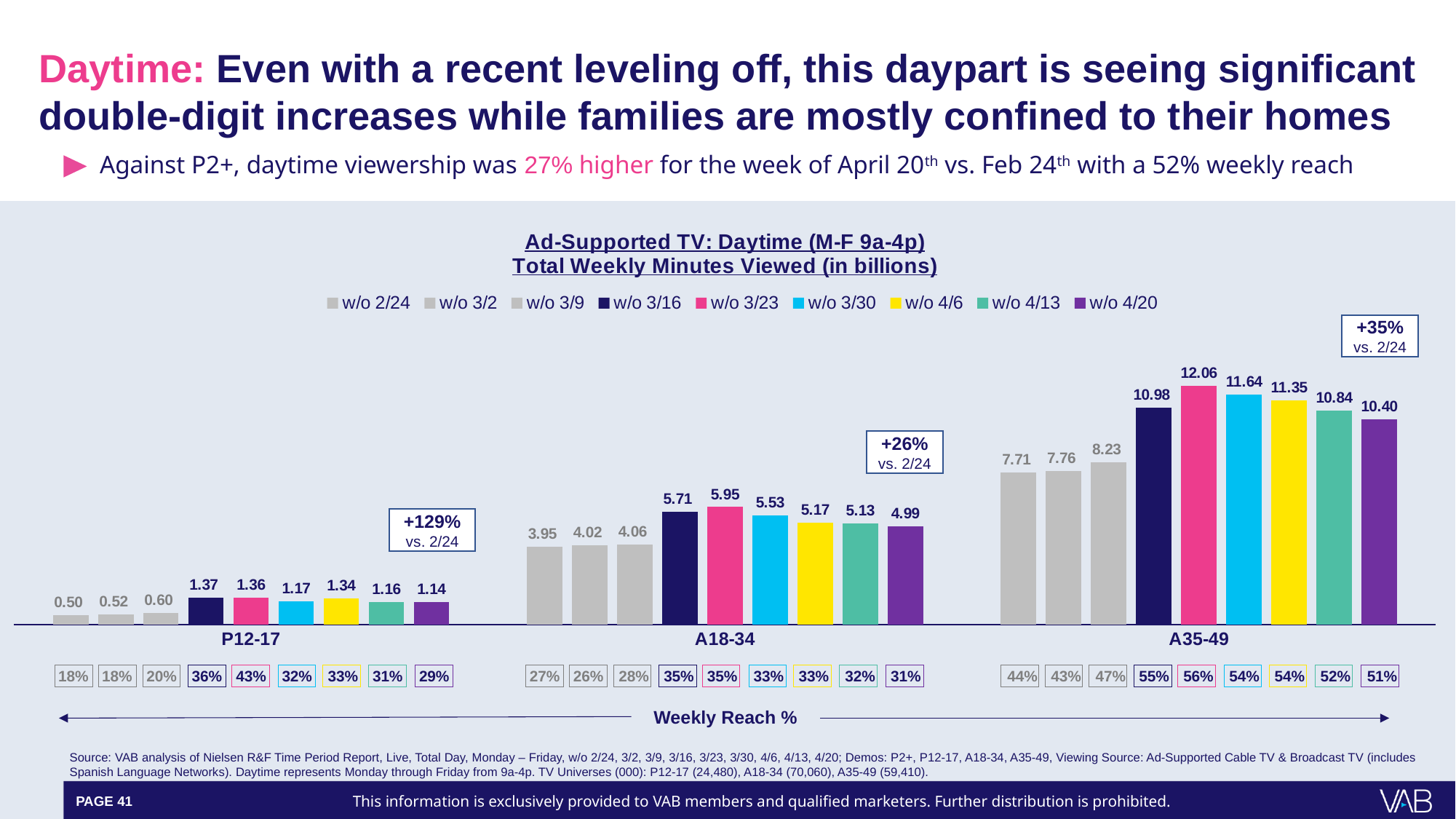
What is the value for A18-34 in the w/o 4/20 series? 4.99 What is the difference between the w/o 3/23 and w/o 2/24 values for A35-49? 4.35 What percentage increase vs. 2/24 is annotated above the A18-34 group? +26% Which week has the highest value for A18-34? w/o 3/23 How many series does the legend list? 9 Which week has the lowest value for A35-49? w/o 2/24 How many demographic categories are shown on the x axis? 3 What is the weekly reach % shown for A35-49 in the w/o 3/23 series? 56% Which is larger for P12-17: the w/o 3/16 value or the w/o 4/6 value? w/o 3/16 What is the value for P12-17 in the w/o 2/24 series? 0.50 What kind of chart is shown on the slide? Bar chart What is the value for A35-49 in the w/o 3/23 series? 12.06